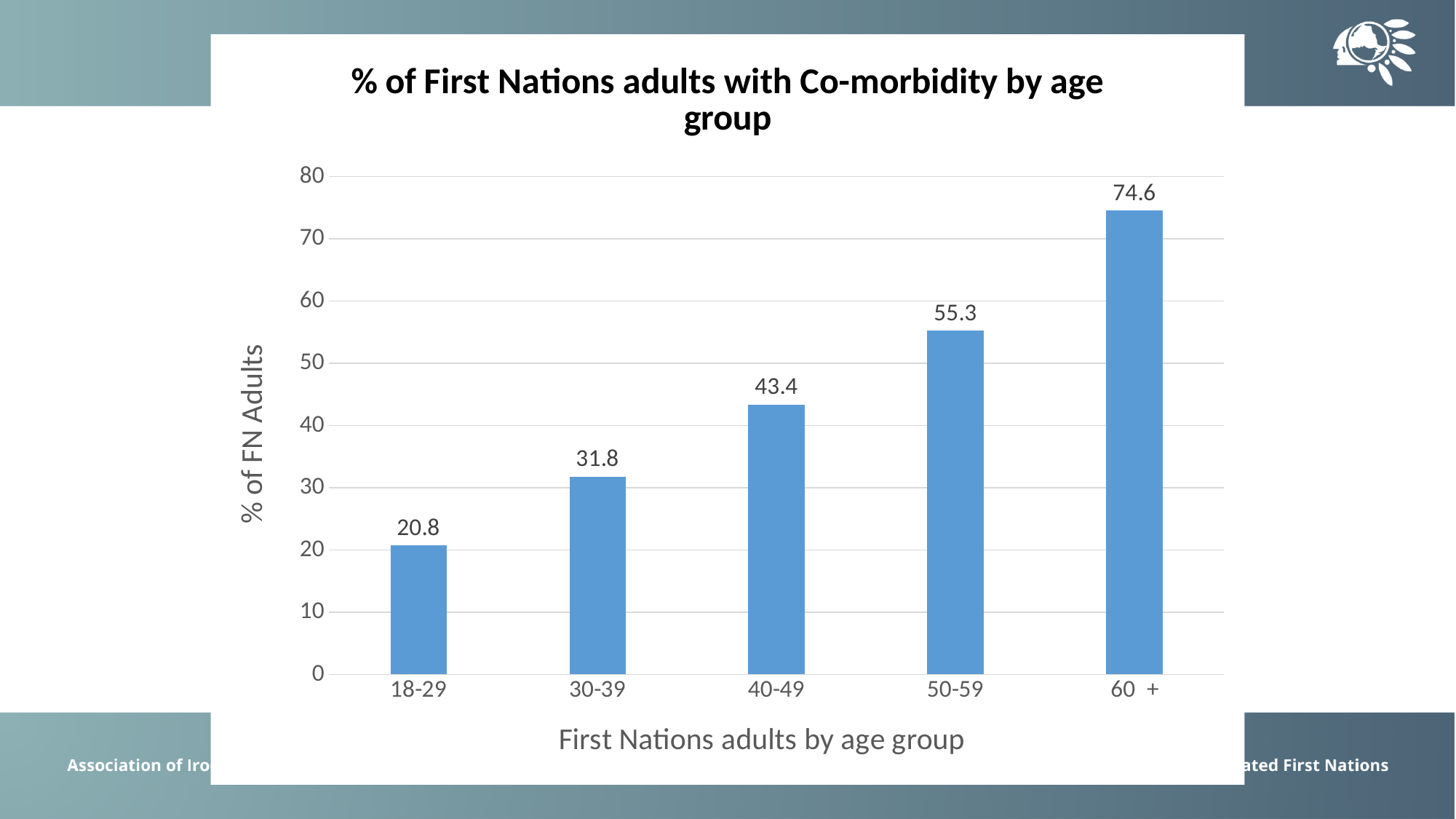
What is the value for the 60 + age group? 74.6 How many age groups are shown on the chart? 5 What is the value for the 18-29 age group? 20.8 What kind of chart is shown on the slide? Bar chart What is the label of the y axis? % of FN Adults Which age group has the highest percentage of adults with co-morbidity? 60 + Which is larger, the value for 40-49 or the value for 30-39? 40-49 Which age group has the lowest percentage of adults with co-morbidity? 18-29 Is the value for the 50-59 age group greater or less than 50? greater What is the difference between the values for the 50-59 and 30-39 age groups? 23.5 What is the value for the 40-49 age group? 43.4 Do the values rise or fall as age group increases along the x axis? Rise